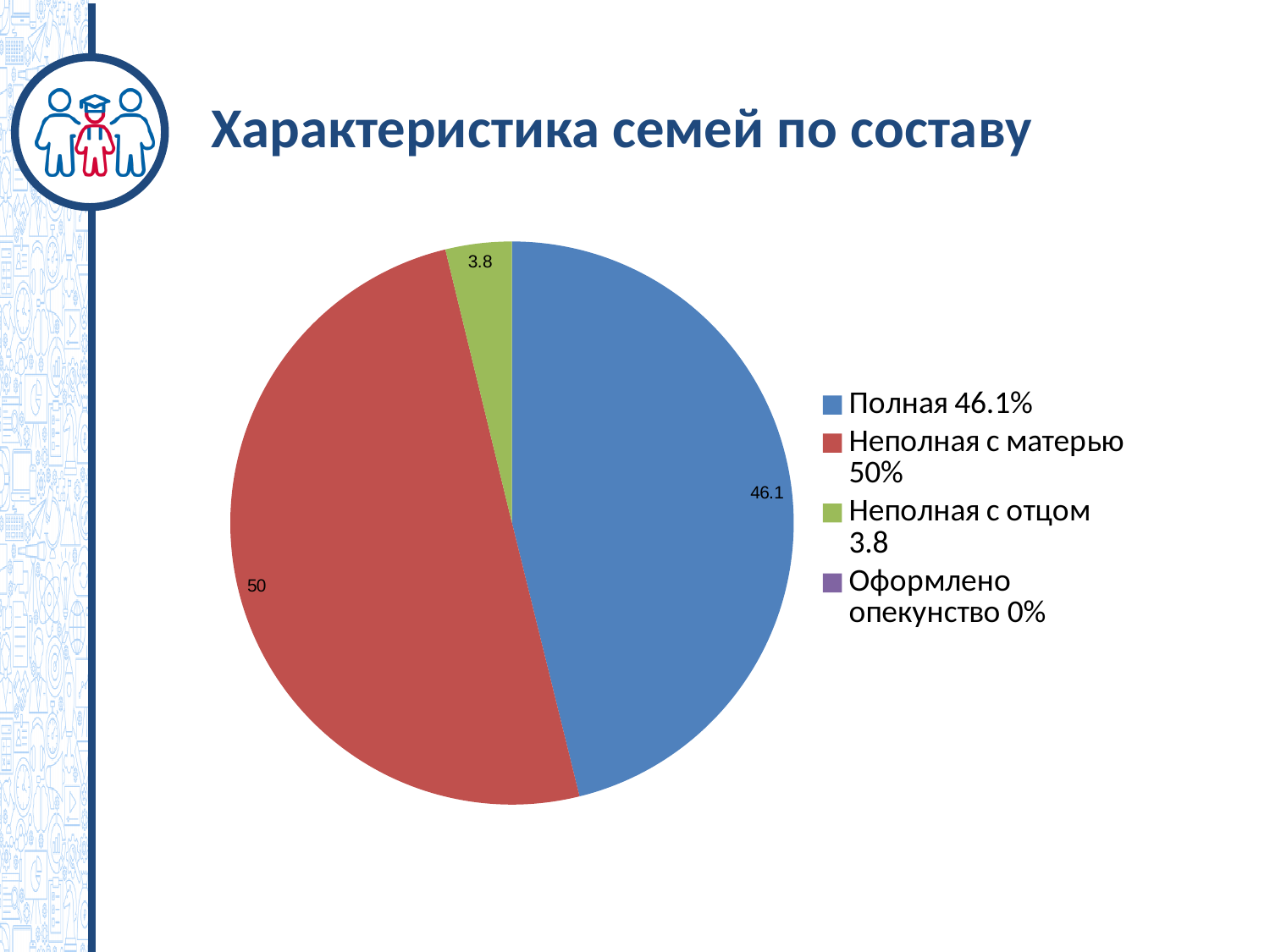
What is the data label on the slice for Неполная с матерью? 50 What is the title of the slide? Характеристика семей по составу Which category has the largest slice of the pie? Неполная с матерью Which is larger, the slice for Полная or the slice for Неполная с отцом? Полная What kind of chart is shown on the slide? pie chart What is the data label on the slice for Неполная с отцом? 3.8 What is the difference between the values for Полная and Неполная с отцом? 42.3 What colour is the slice for Неполная с матерью? red What is the data label on the slice for Полная? 46.1 Which category with a visible slice has the smallest share of the pie? Неполная с отцом What is the difference between the values for Неполная с матерью and Полная? 3.9 How many entries does the legend list? 4